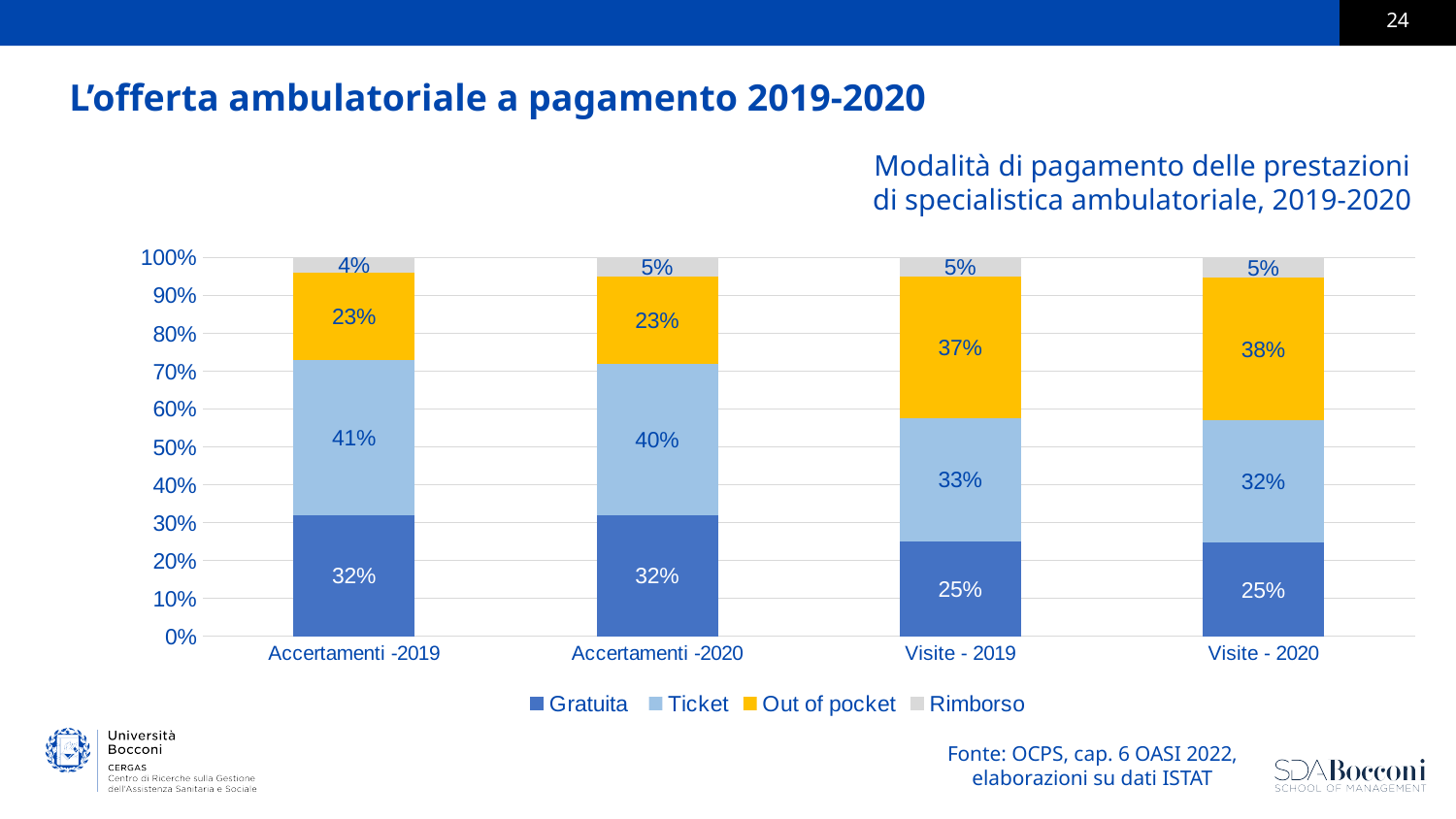
What is the Rimborso share for Accertamenti -2019? 4% Which series is shown in yellow? Out of pocket What is the Out of pocket share for Visite - 2020? 38% Is the Ticket share larger for Accertamenti -2020 or for Visite - 2020? Accertamenti -2020 Which category has the highest Out of pocket share? Visite - 2020 What is the Ticket share for Accertamenti -2019? 41% What is the difference between the Out of pocket share for Visite - 2019 and for Accertamenti -2019? 14% How many categories are shown on the x axis? 4 How many series does the legend list? 4 What is the Gratuita share for Visite - 2019? 25% Which category has the lowest Rimborso share? Accertamenti -2019 What kind of chart is shown on the slide? Stacked bar chart